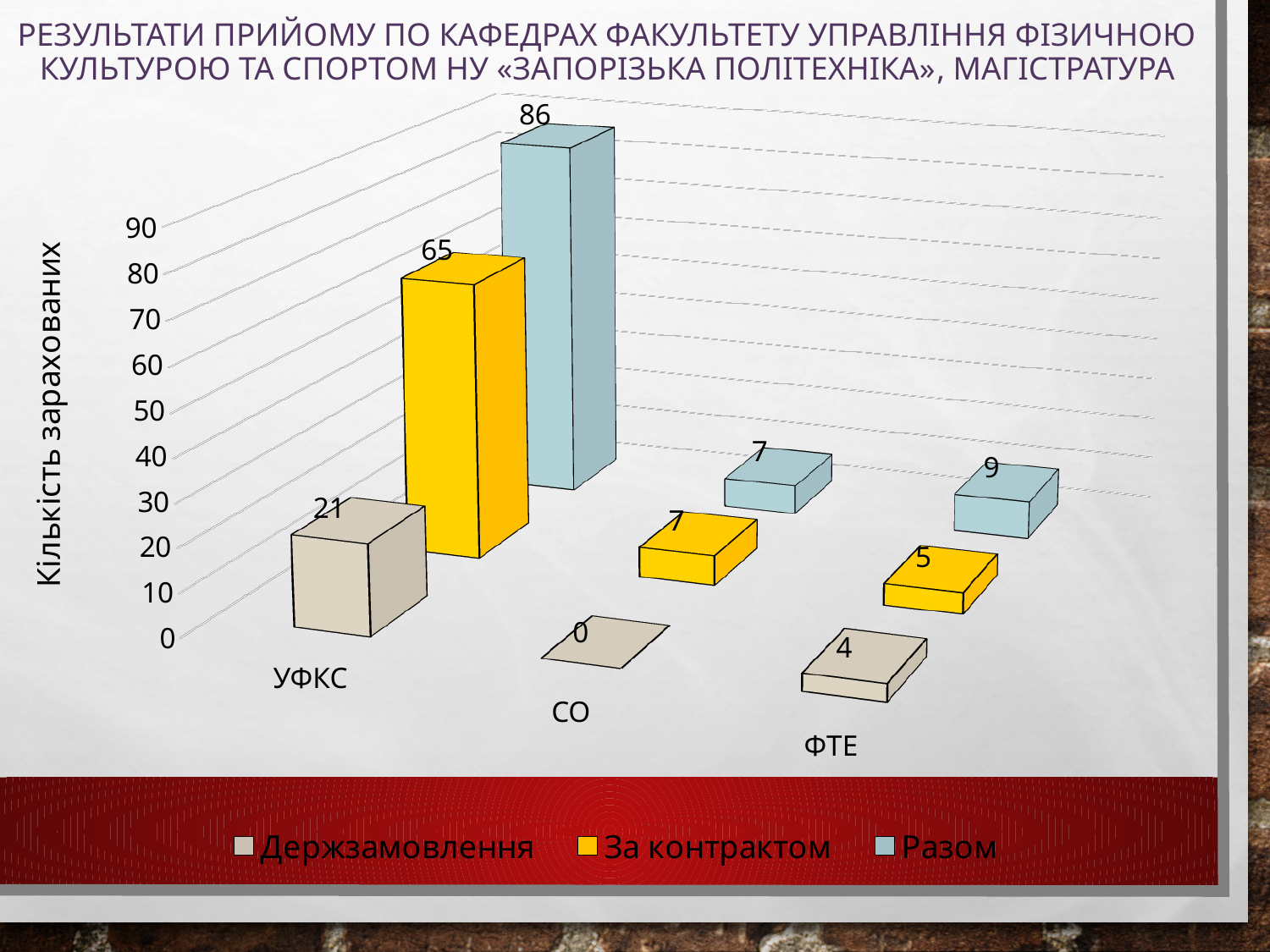
What type of chart is shown on the slide? bar chart How many categories are shown on the x axis? 3 What is the label of the vertical axis? Кількість зарахованих Which is larger: За контрактом for ФТЕ or За контрактом for СО? За контрактом for СО What is the value of Держзамовлення for СО? 0 Which category has the lowest Держзамовлення value? СО Which category has the highest Разом value? УФКС What is the value of Разом for УФКС? 86 How many series does the legend list? 3 What is the value of Разом for ФТЕ? 9 What is the value of За контрактом for УФКС? 65 What is the difference between the Разом value for УФКС and the Разом value for ФТЕ? 77